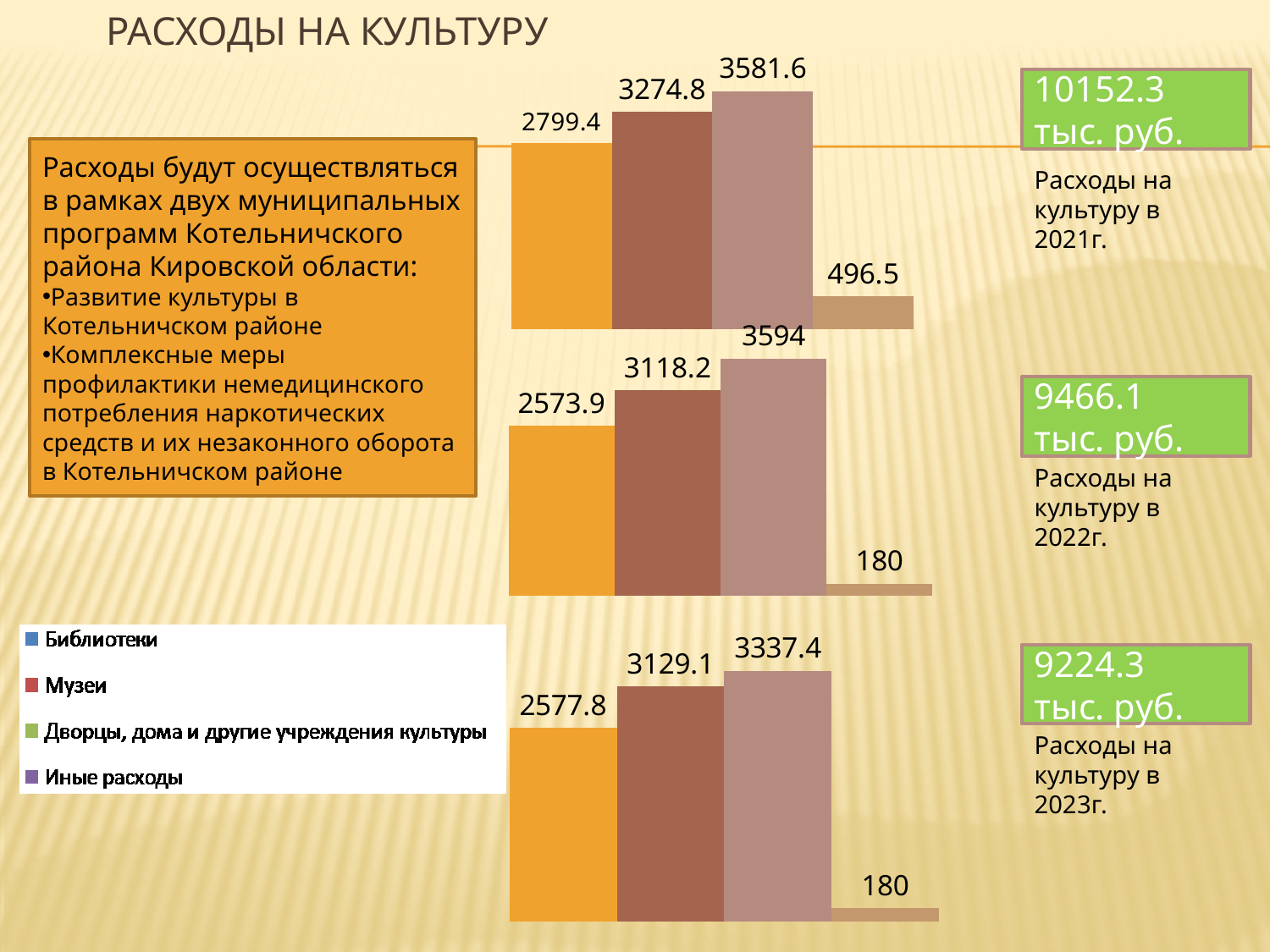
In the bottom chart (2023), what is the value of the last bar (Иные расходы)? 180 In the middle chart (2022), what is the value of the first bar (Библиотеки)? 2573.9 In the bottom chart (2023), how much larger is the Музеи value than the Библиотеки value? 551.3 In the middle chart (2022), which category has the lowest value? Иные расходы In the top chart (2021), what is the difference between the third bar (3581.6) and the second bar (3274.8)? 306.8 Which is larger: the third bar in the middle chart (2022) or the third bar in the bottom chart (2023)? The middle chart (2022), 3594 How many entries does the legend list? 4 In the middle chart (2022), which is larger: the Музеи bar or the Библиотеки bar? Музеи In the top chart (2021), what is the value of the third bar (Дворцы, дома и другие учреждения культуры)? 3581.6 How many bars does each of the three charts contain? 4 What type of chart is used to show the culture expenses for each year? Bar chart In the top chart (2021), which category has the highest value? Дворцы, дома и другие учреждения культуры